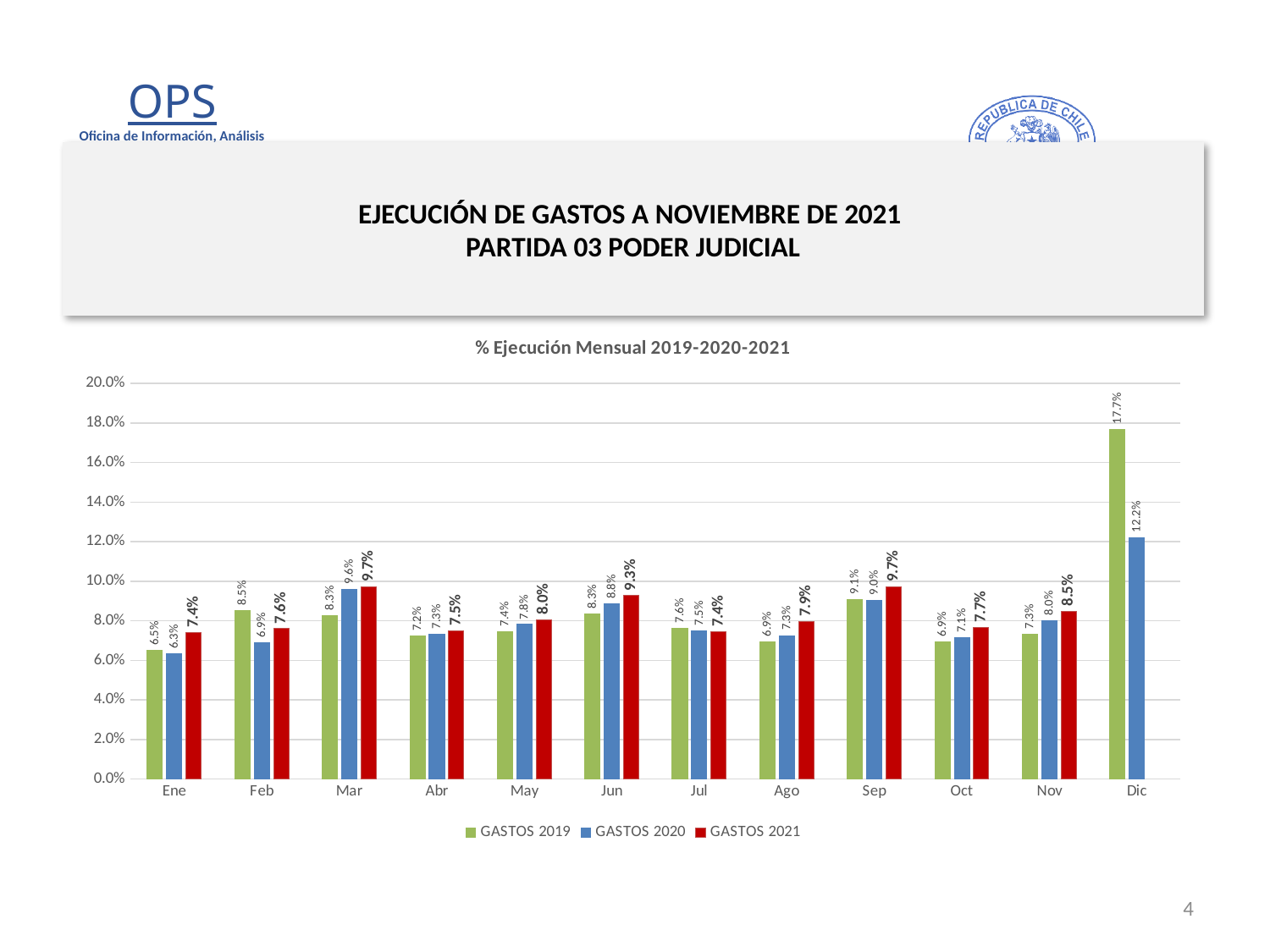
Is the value for GASTOS 2019 in Dic greater or less than 16.0%? greater What is the value for GASTOS 2021 in Mar? 9.7% How many series does the legend list? 3 Which month has the highest value for GASTOS 2020? Dic How many months are shown on the x axis? 12 Which is larger in Feb: GASTOS 2019 or GASTOS 2020? GASTOS 2019 What is the difference between GASTOS 2019 and GASTOS 2020 in Dic? 5.5% What kind of chart is shown on the slide? Bar chart What is the title of the chart? % Ejecución Mensual 2019-2020-2021 What is the value for GASTOS 2020 in Nov? 8.0% What is the value for GASTOS 2019 in Dic? 17.7%